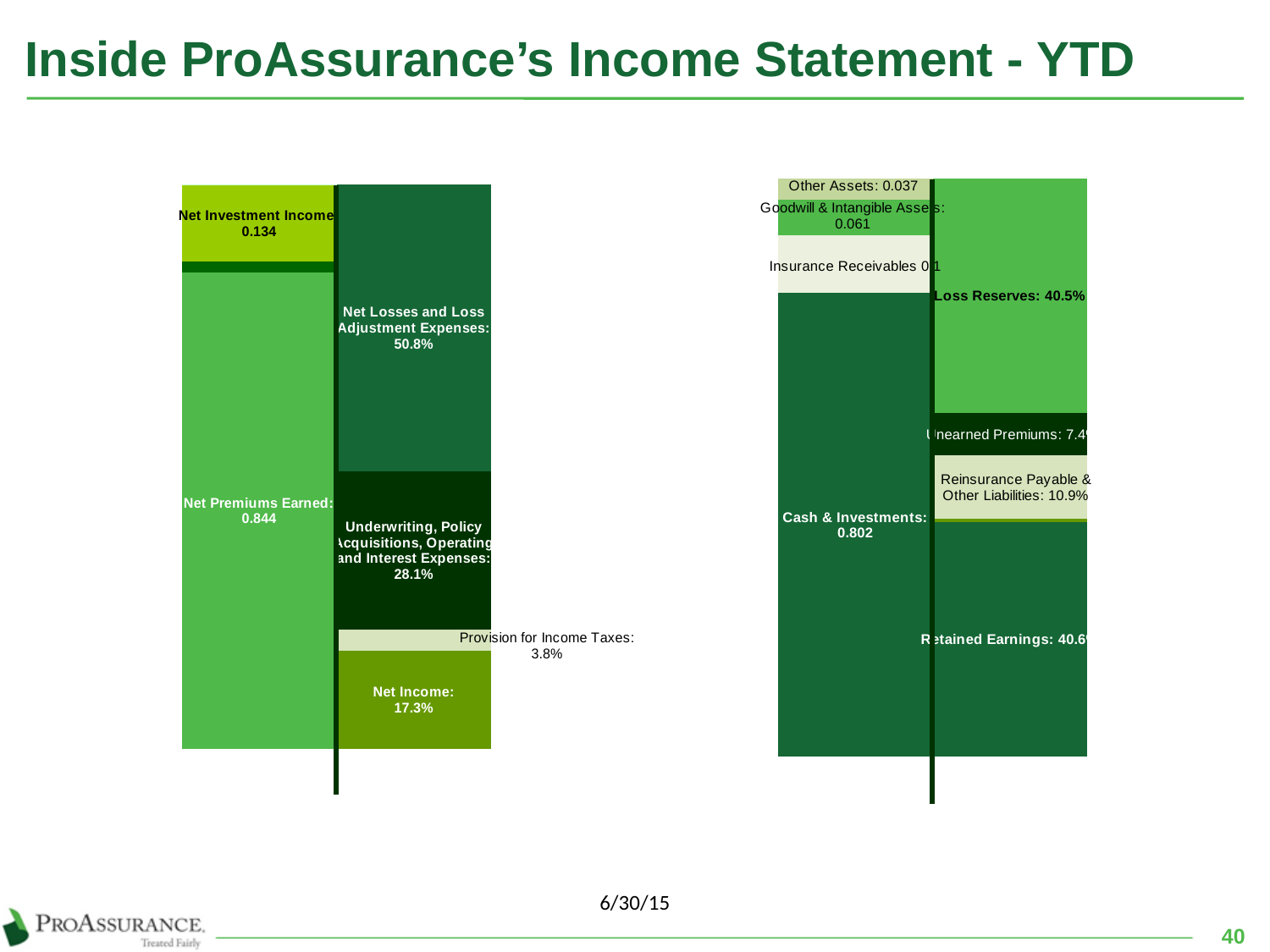
On the left chart, what is the value shown for Net Premiums Earned? 0.844 On the right chart, which is larger, Goodwill & Intangible Assets or Other Assets? Goodwill & Intangible Assets On the left chart, what percentage is shown for Provision for Income Taxes? 3.8% On the left chart, which segment of the right-hand bar has the smallest percentage? Provision for Income Taxes On the right chart, what is the value shown for Cash & Investments? 0.802 On the left chart, what percentage is shown for Net Income? 17.3% On the left chart, what is the value shown for Net Investment Income? 0.134 On the left chart, which segment of the right-hand bar has the largest percentage? Net Losses and Loss Adjustment Expenses On the right chart, what percentage is shown for Reinsurance Payable & Other Liabilities? 10.9% On the left chart, what is the difference between the Net Losses and Loss Adjustment Expenses percentage and the Underwriting, Policy Acquisitions, Operating and Interest Expenses percentage? 22.7% On the left chart, what percentage is shown for Net Losses and Loss Adjustment Expenses? 50.8% On the right chart, what is the value shown for Other Assets? 0.037